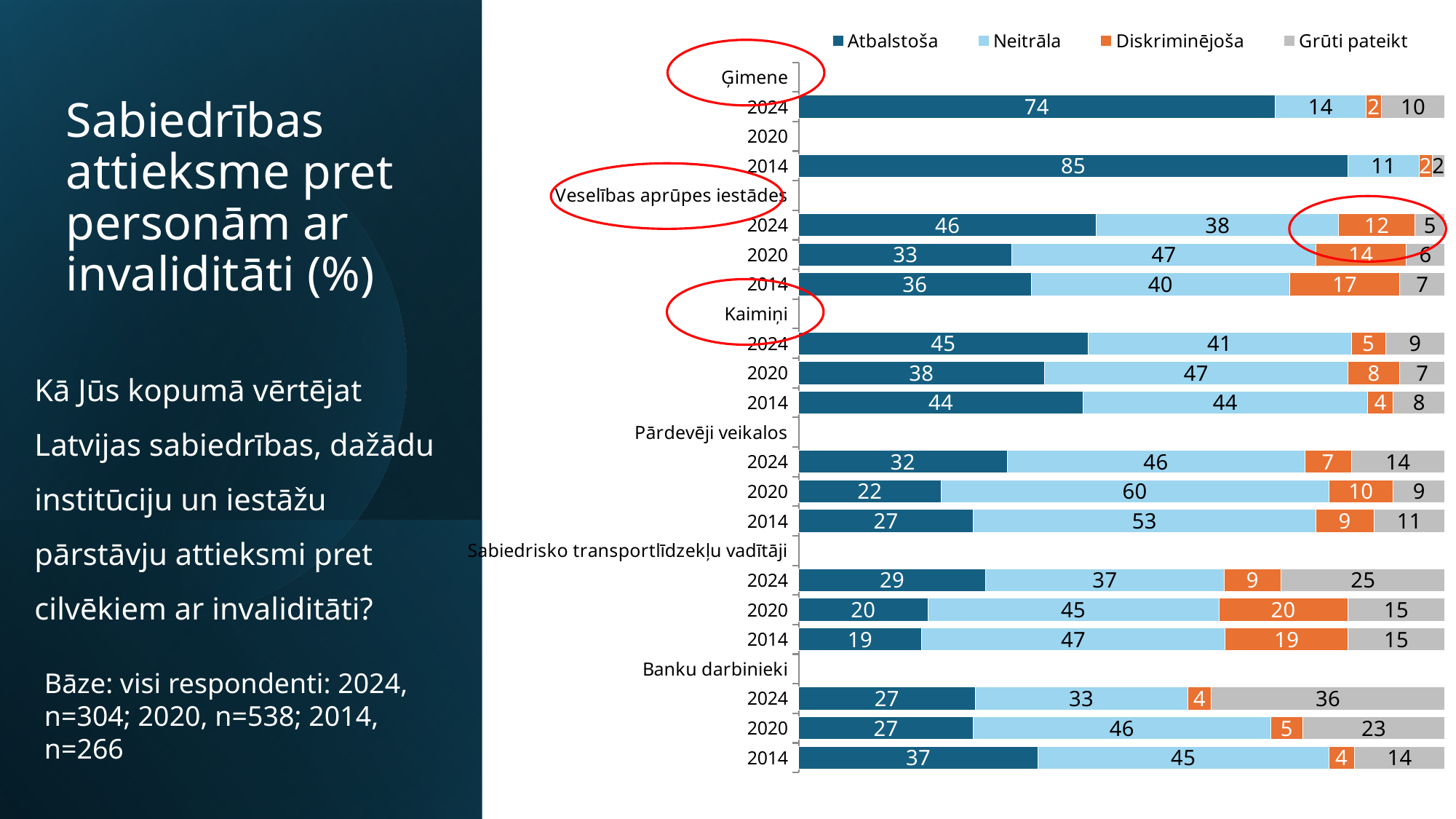
Which series is shown in orange in the legend? Diskriminējoša What is the difference between the Atbalstoša values for Ģimene in 2014 and 2024? 11 Which year has the lowest Atbalstoša value for Sabiedrisko transportlīdzekļu vadītāji? 2014 What is the total of the stacked bar for Banku darbinieki in 2014? 100 What is the Atbalstoša value for Ģimene in 2024? 74 What is the Neitrāla value for Pārdevēji veikalos in 2020? 60 How many series does the legend list? 4 What kind of chart is shown on the slide? stacked bar chart Which is larger: the Diskriminējoša value for Kaimiņi in 2020 or in 2014? 2020 What is the Diskriminējoša value for Sabiedrisko transportlīdzekļu vadītāji in 2020? 20 Which year has the highest Atbalstoša value for Veselības aprūpes iestādes? 2024 What is the Grūti pateikt value for Banku darbinieki in 2024? 36